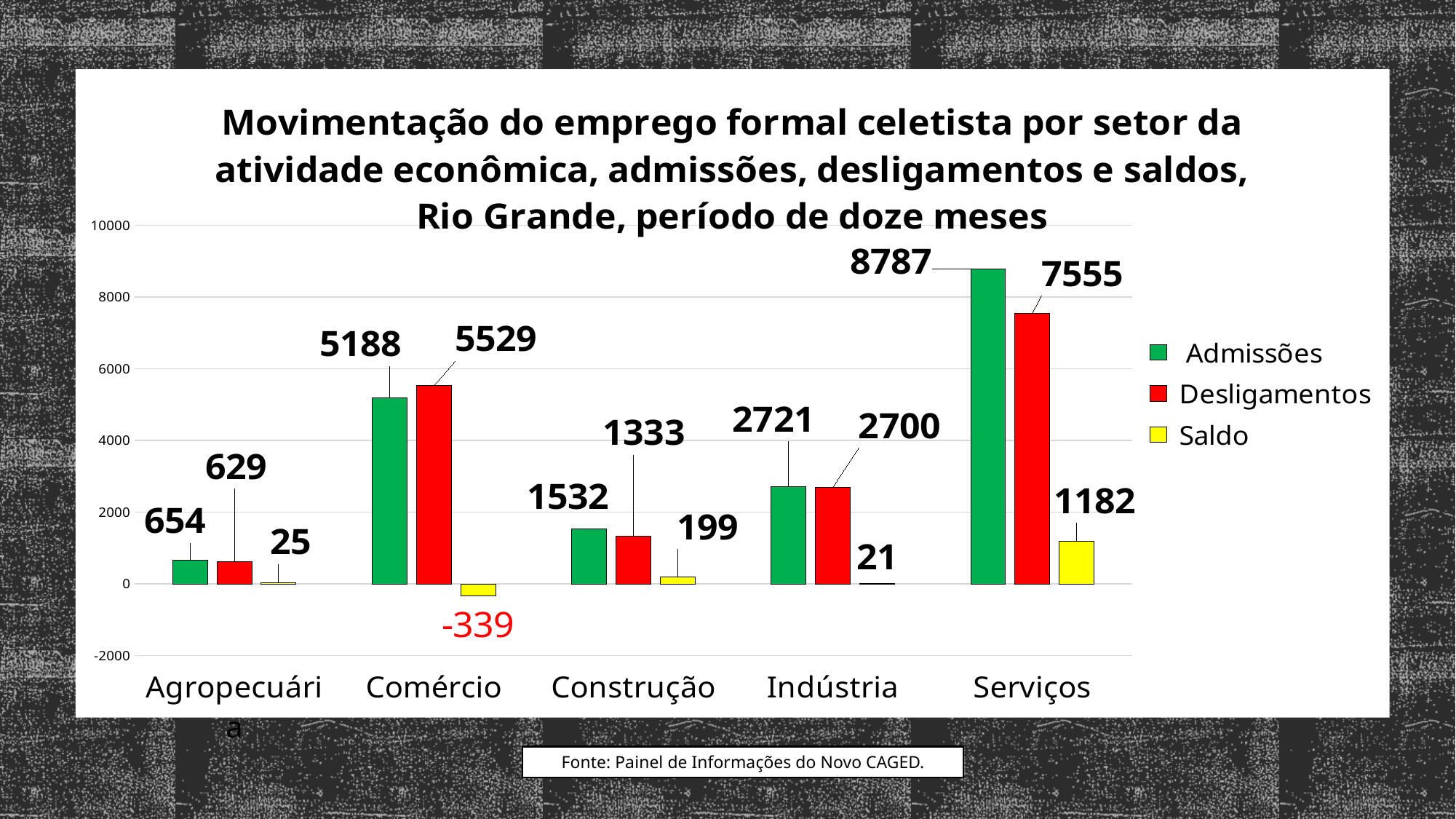
For Comércio, which is larger: Admissões or Desligamentos? Desligamentos What is the difference between Admissões and Desligamentos for Serviços? 1232 What is the value of Admissões for Serviços? 8787 Is the Desligamentos value for Serviços greater or less than 6000? greater Which sector has the highest Admissões value? Serviços What kind of chart is shown on the slide? bar chart What is the value of Desligamentos for Comércio? 5529 Which sector has the lowest Desligamentos value? Agropecuária How many sectors are shown on the x axis? 5 What is the Saldo value for Comércio? -339 How many series does the legend list? 3 What is the Saldo value for Indústria? 21